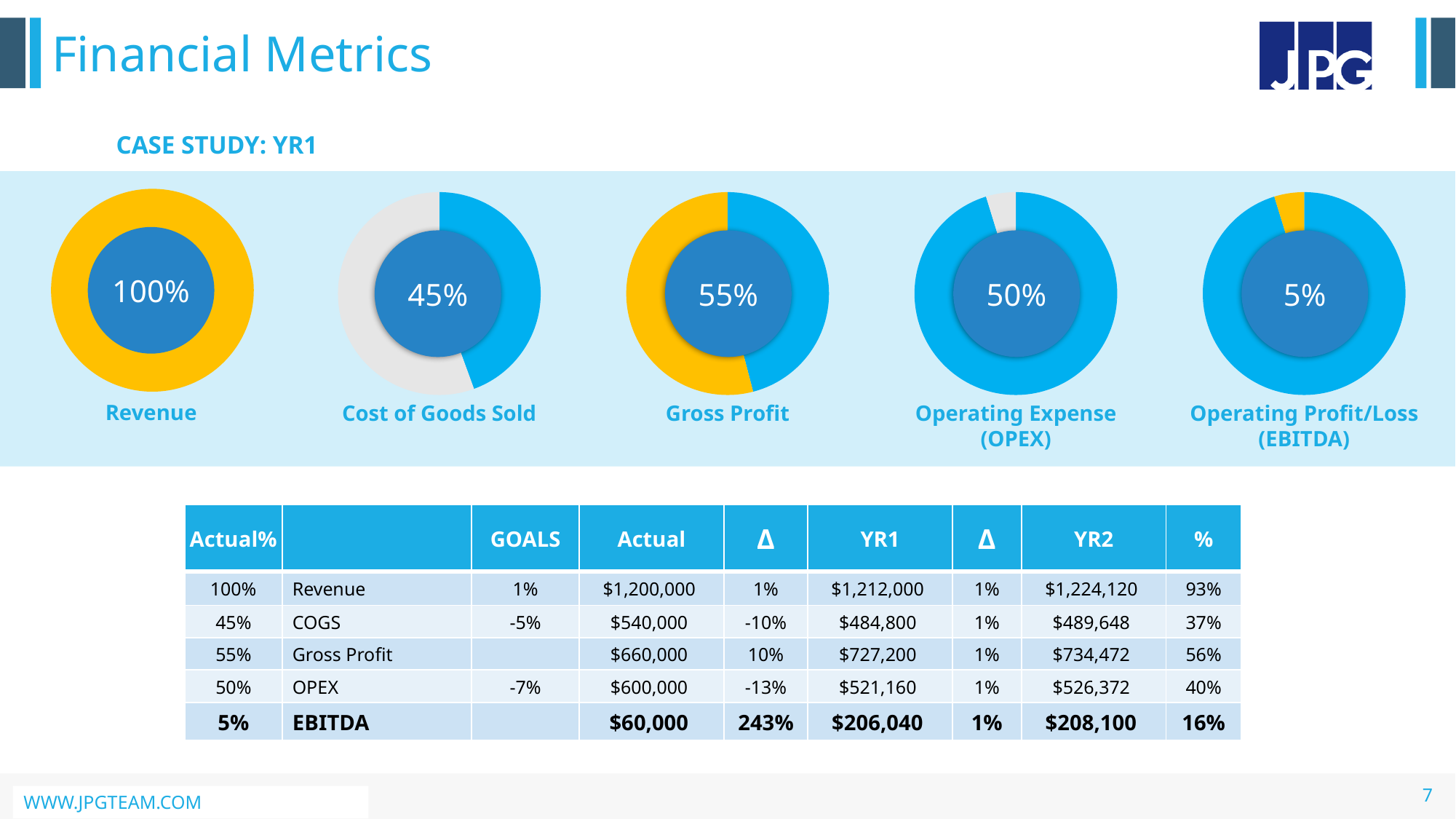
Which of the five donut charts shows the lowest percentage? Operating Profit/Loss (EBITDA) What is the difference between the percentage shown in the Gross Profit donut chart and the Cost of Goods Sold donut chart? 10% What value is shown in the centre of the Operating Profit/Loss (EBITDA) donut chart? 5% Which of the five donut charts shows the highest percentage? Revenue What is the difference between the percentage shown in the Operating Expense (OPEX) donut chart and the Operating Profit/Loss (EBITDA) donut chart? 45% How many donut charts are shown on the slide? 5 What value is shown in the centre of the Operating Expense (OPEX) donut chart? 50% What value is shown in the centre of the Revenue donut chart? 100% What value is shown in the centre of the Gross Profit donut chart? 55% Which shows a larger percentage, the Operating Expense (OPEX) donut chart or the Gross Profit donut chart? Gross Profit What value is shown in the centre of the Cost of Goods Sold donut chart? 45% What kind of chart is used to display the Revenue metric? Donut chart